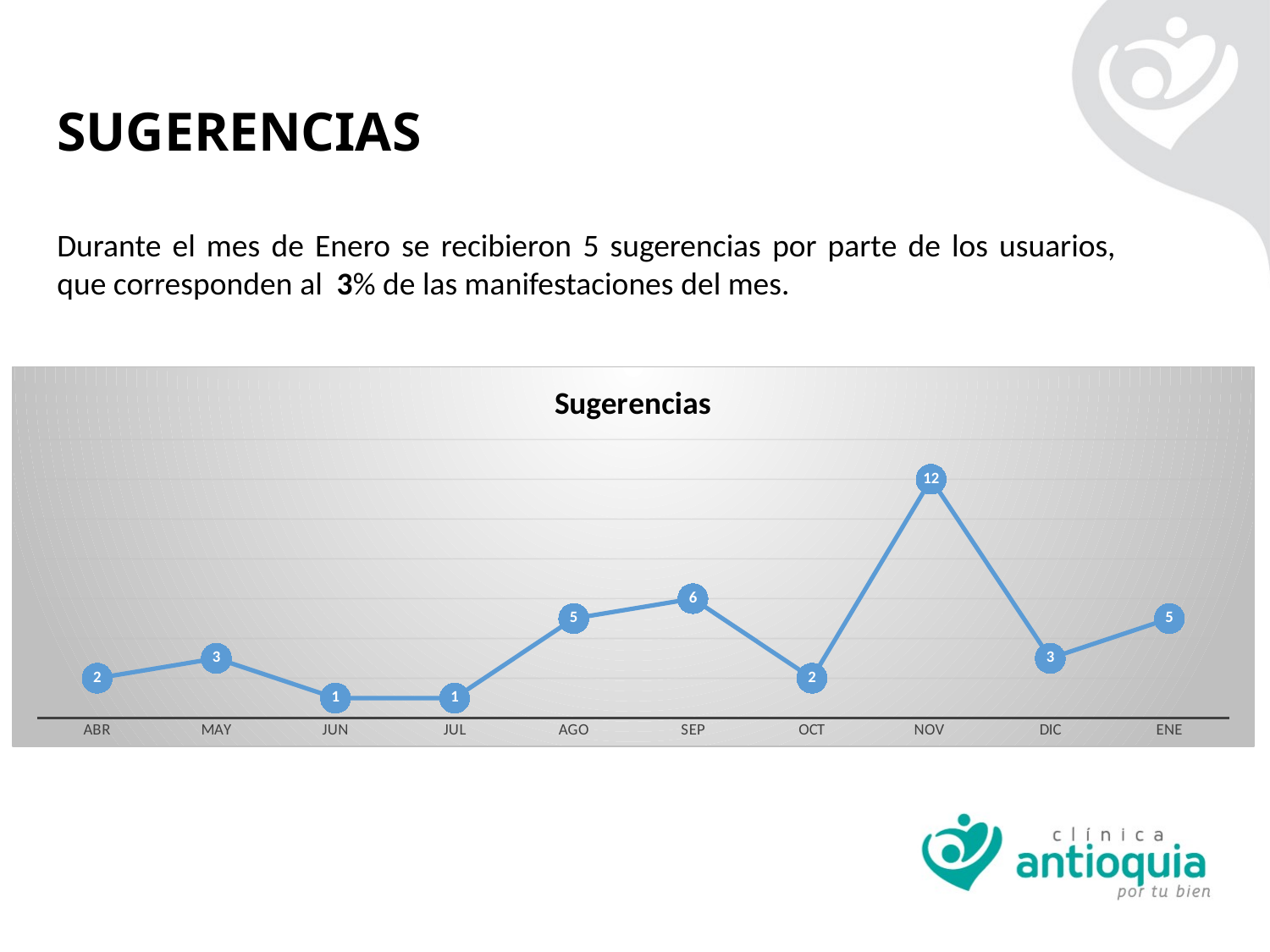
What is the value for AGO? 5 What is the title of the chart? Sugerencias What kind of chart is shown? Line chart Which months have the lowest value? JUN and JUL Do the values rise or fall from OCT to NOV? Rise How many months are plotted on the x axis? 10 What is the difference between the values for NOV and DIC? 9 Which is larger, the value for SEP or the value for OCT? SEP What is the value for NOV? 12 What is the value for ENE? 5 What is the difference between the values for ENE and DIC? 2 Which month has the highest value? NOV